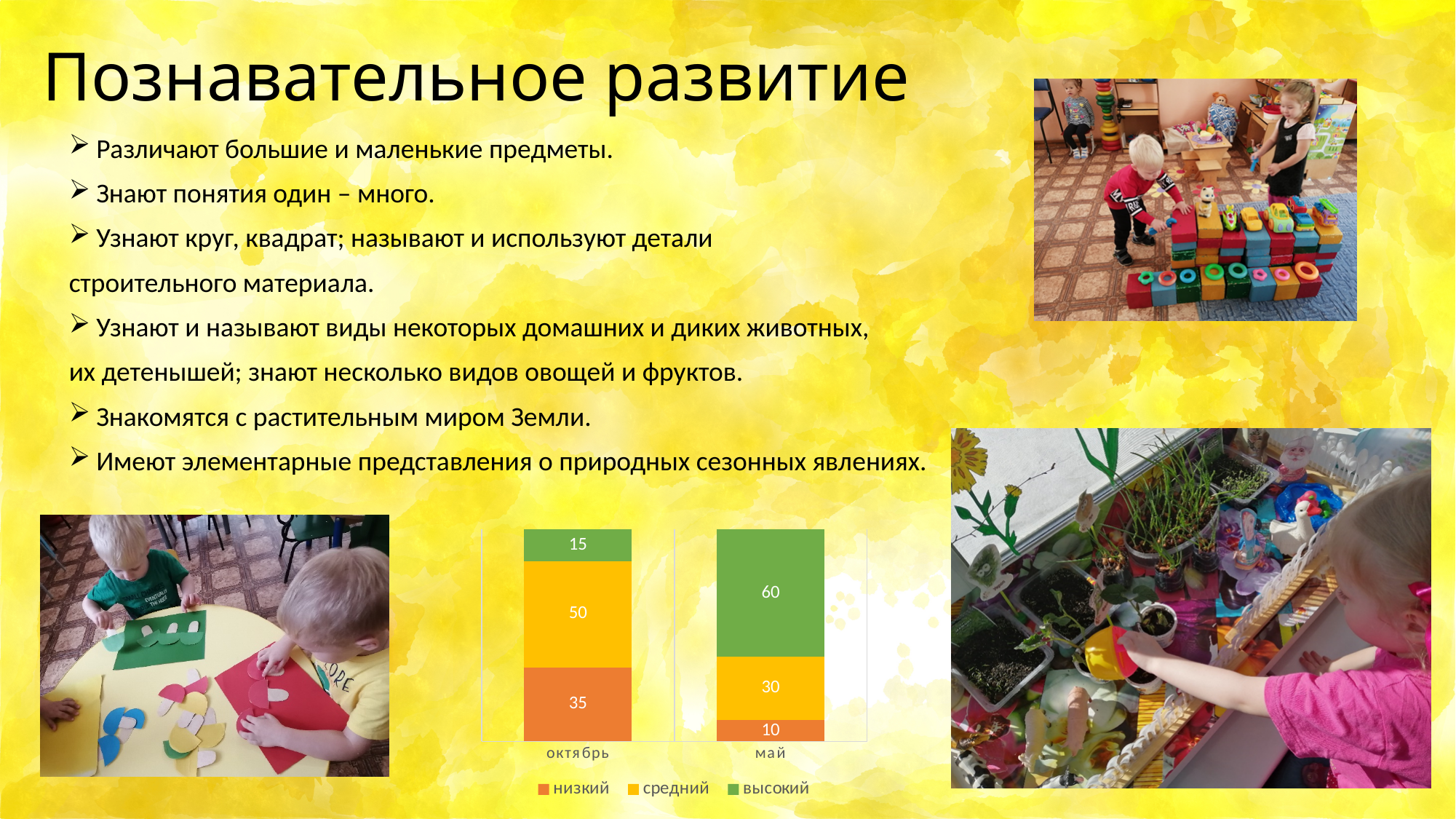
Which is larger: средний in октябрь or средний in май? средний in октябрь What kind of chart is shown on the slide? stacked bar chart How many categories are shown on the x axis of the chart? 2 What is the value for средний in октябрь? 50 What is the value for высокий in май? 60 What is the total of the stacked bar for октябрь? 100 What is the difference between the высокий values for май and октябрь? 45 How many series does the chart legend list? 3 Which series has the highest value in май? высокий Which series has the lowest value in октябрь? высокий What is the value for низкий in май? 10 What is the value for низкий in октябрь? 35